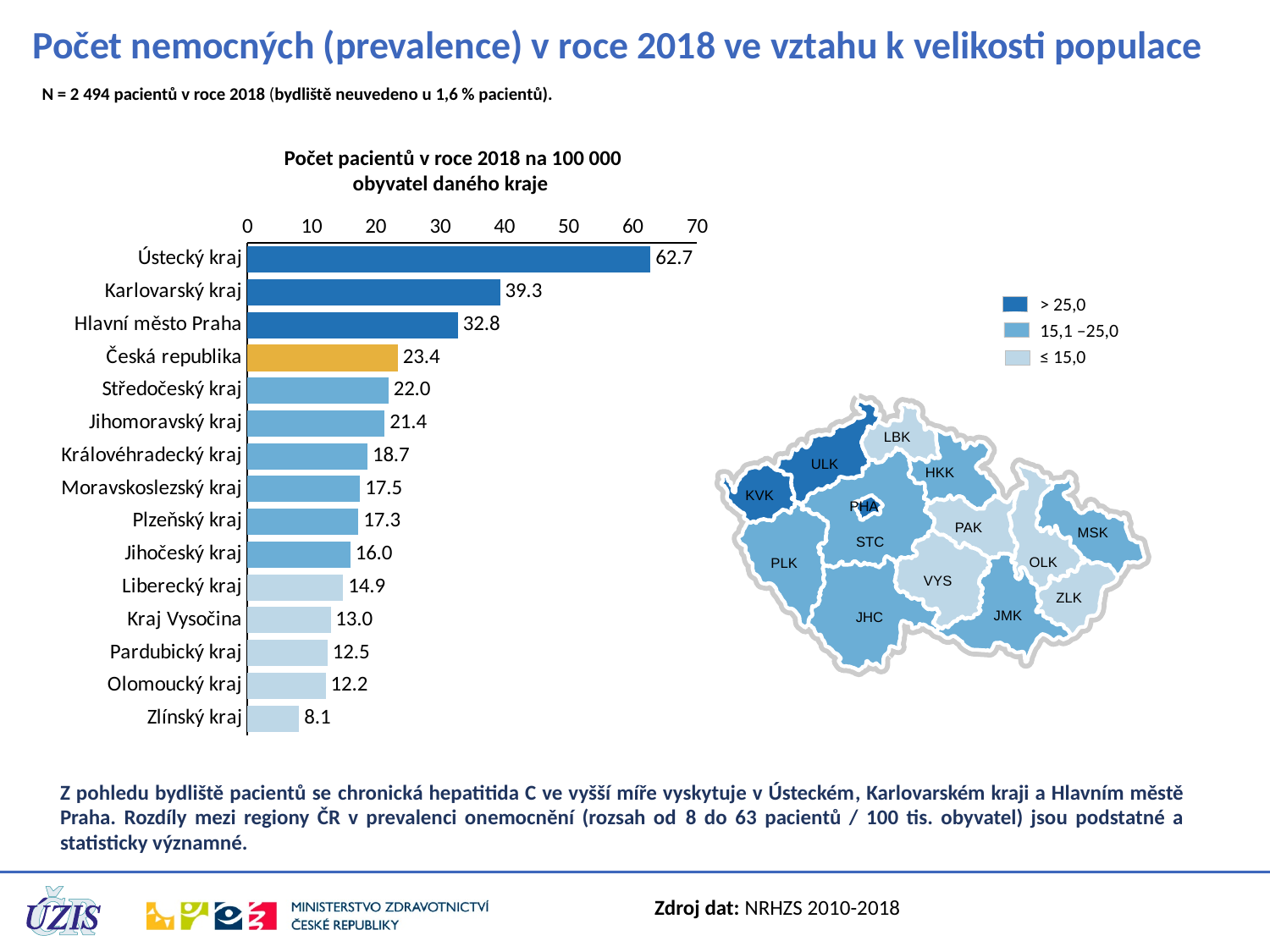
What is the value for Česká republika in the bar chart? 23.4 What is the value for Kraj Vysočina in the bar chart? 13.0 Which region has the lowest value in the bar chart? Zlínský kraj Which region has the highest value in the bar chart? Ústecký kraj How many bars are shown in the bar chart? 15 What is the title of the bar chart? Počet pacientů v roce 2018 na 100 000 obyvatel daného kraje Which has a larger value, Středočeský kraj or Jihočeský kraj? Středočeský kraj What type of chart is used to show the number of patients per 100 000 inhabitants? Bar chart What is the difference between the values for Ústecký kraj and Karlovarský kraj? 23.4 What is the difference between the values for Hlavní město Praha and Česká republika? 9.4 What is the value for Ústecký kraj in the bar chart? 62.7 Which has a larger value, Pardubický kraj or Liberecký kraj? Liberecký kraj